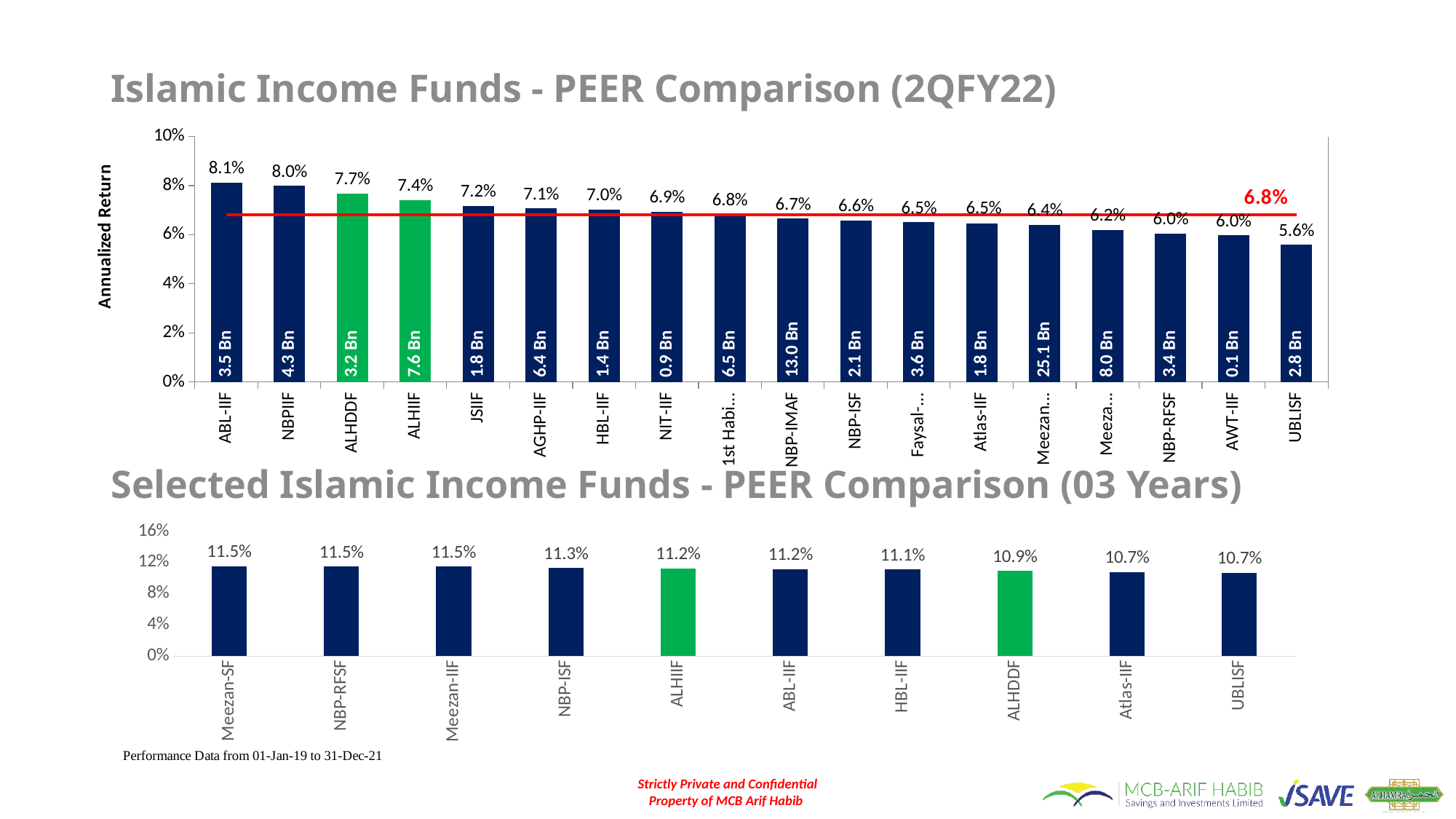
In the top chart (Islamic Income Funds - PEER Comparison (2QFY22)), what is the annualized return for ALHDDF? 7.7% In the top chart (2QFY22), which fund has the highest annualized return? ABL-IIF In the bottom chart (Selected Islamic Income Funds - PEER Comparison (03 Years)), what is the value for NBP-ISF? 11.3% In the bottom chart (03 Years), how many funds are shown? 10 In the top chart (2QFY22), what is the annualized return for NIT-IIF? 6.9% In the top chart (2QFY22), what is the difference between the annualized returns of ABL-IIF and ALHIIF? 0.7% In the bottom chart (03 Years), what is the value for ALHDDF? 10.9% In the top chart (2QFY22), how many funds are shown? 18 In the bottom chart (03 Years), which is larger, the value for Meezan-SF or the value for UBLISF? Meezan-SF In the top chart (2QFY22), what fund size is printed inside the NBP-IMAF bar? 13.0 Bn In the top chart (2QFY22), what value is labelled on the red horizontal line? 6.8% In the top chart (2QFY22), which fund has the lowest annualized return? UBLISF